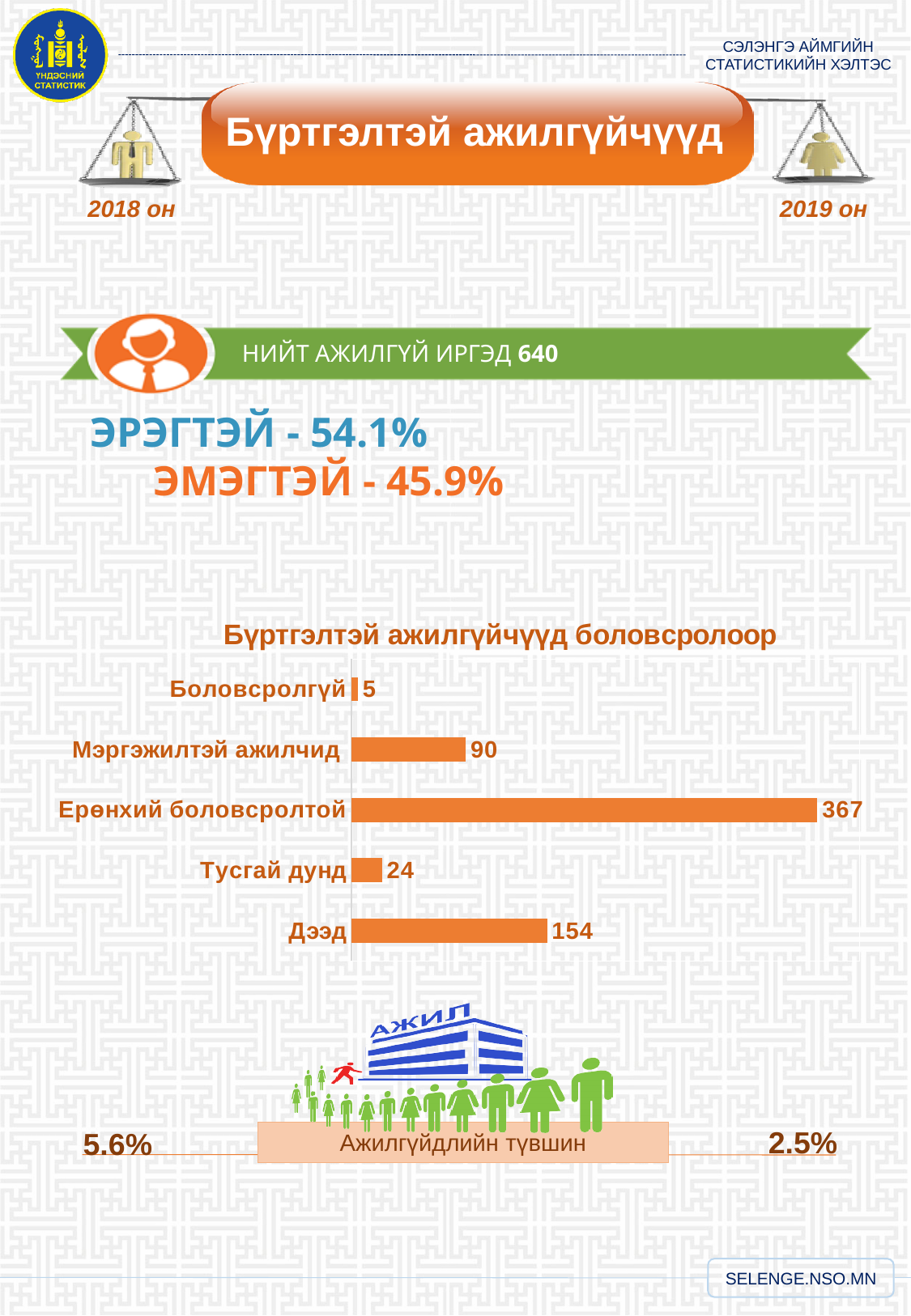
What kind of chart is 'Бүртгэлтэй ажилгүйчүүд боловсролоор'? Bar chart Which is larger in the chart 'Бүртгэлтэй ажилгүйчүүд боловсролоор': Мэргэжилтэй ажилчид or Тусгай дунд? Мэргэжилтэй ажилчид What is the value for Боловсролгүй in the chart 'Бүртгэлтэй ажилгүйчүүд боловсролоор'? 5 What is the title of the chart on the slide? Бүртгэлтэй ажилгүйчүүд боловсролоор What is the value for Тусгай дунд in the chart 'Бүртгэлтэй ажилгүйчүүд боловсролоор'? 24 What is the value for Ерөнхий боловсролтой in the chart 'Бүртгэлтэй ажилгүйчүүд боловсролоор'? 367 How many categories are shown in the chart 'Бүртгэлтэй ажилгүйчүүд боловсролоор'? 5 Which category has the highest value in the chart 'Бүртгэлтэй ажилгүйчүүд боловсролоор'? Ерөнхий боловсролтой What is the value for Дээд in the chart 'Бүртгэлтэй ажилгүйчүүд боловсролоор'? 154 What is the difference between the values for Ерөнхий боловсролтой and Дээд in the chart 'Бүртгэлтэй ажилгүйчүүд боловсролоор'? 213 Which category has the lowest value in the chart 'Бүртгэлтэй ажилгүйчүүд боловсролоор'? Боловсролгүй What is the value for Мэргэжилтэй ажилчид in the chart 'Бүртгэлтэй ажилгүйчүүд боловсролоор'? 90